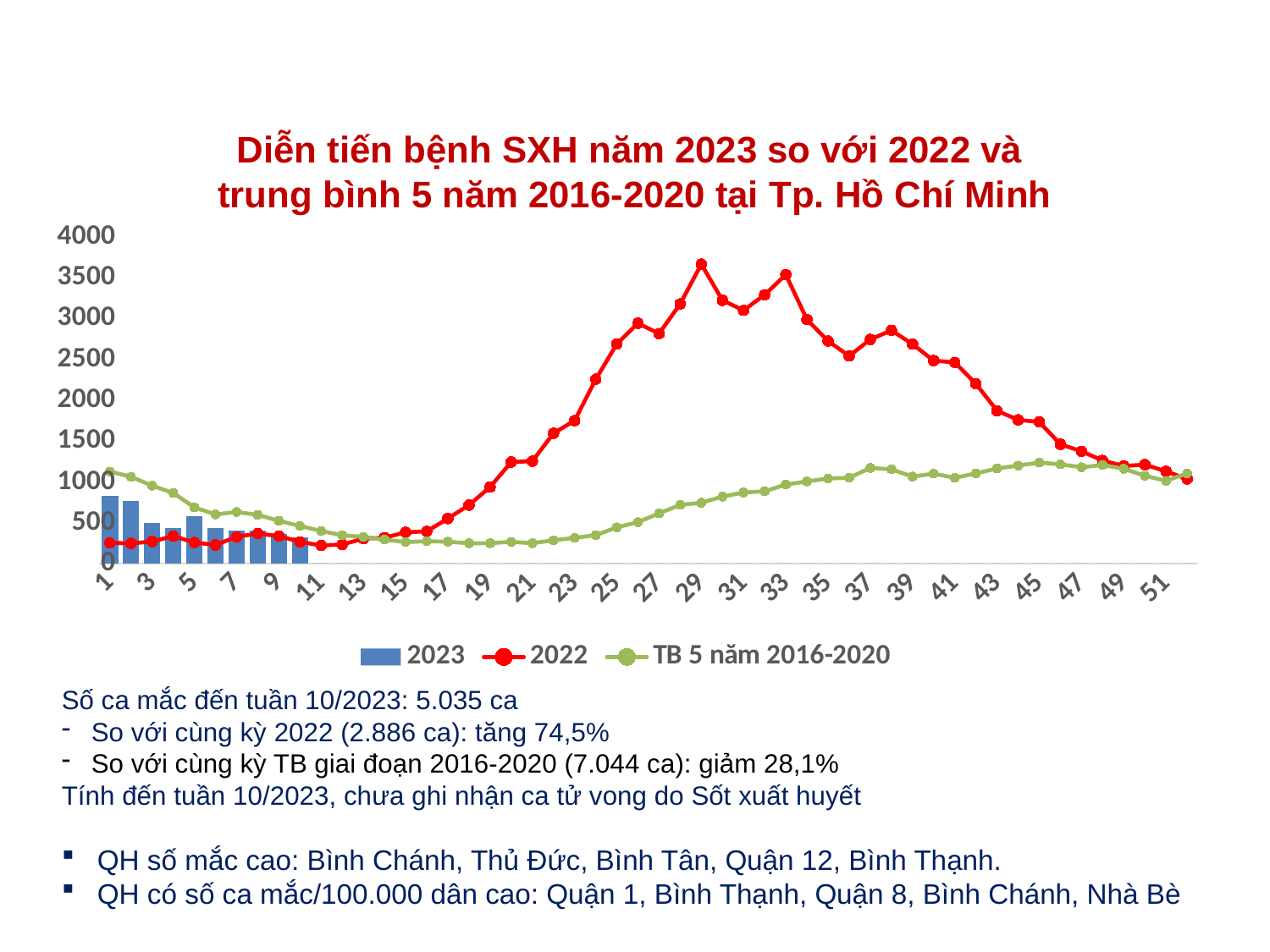
Is the 2023 bar at week 1 greater or less than 500? greater At week 29, which series is higher: 2022 or TB 5 năm 2016-2020? 2022 What kind of chart is this? Combined bar and line chart At week 1, which is higher: the 2023 bar or the 2022 line? 2023 How many weeks have a 2023 bar plotted? 10 In which week does the 2022 line reach its highest value? Week 29 Which series is drawn as bars rather than a line? 2023 Does the 2022 line rise or fall from week 15 to week 29? rise What are the three series named in the legend? 2023, 2022, TB 5 năm 2016-2020 Is the 2022 value at week 1 greater or less than 500? less Is the 2022 value at week 29 greater or less than 3500? greater How many series does the legend list? 3